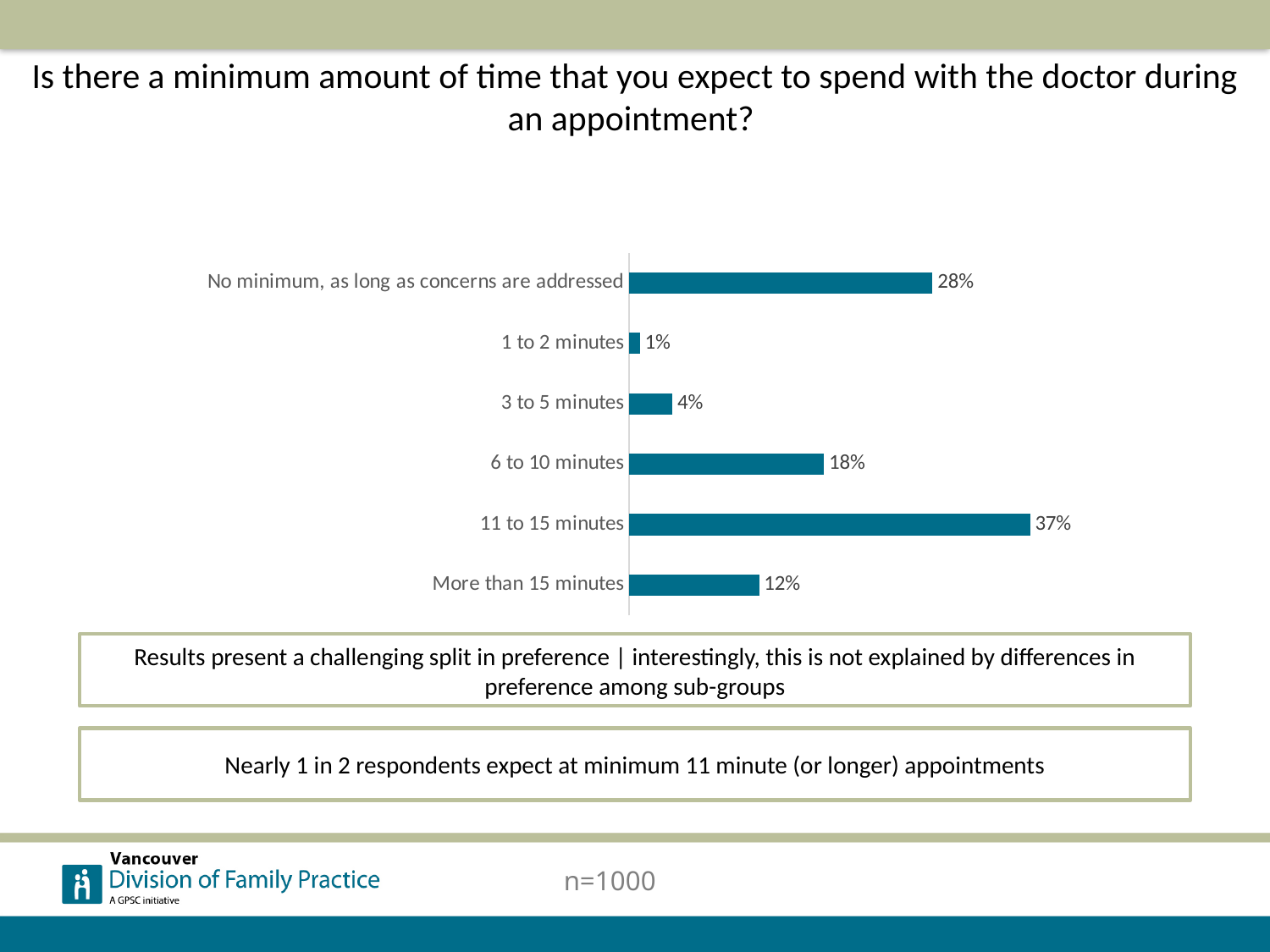
Which category has the lowest percentage? 1 to 2 minutes What is the difference in percentage points between "11 to 15 minutes" and "6 to 10 minutes"? 19 What is the combined percentage for "11 to 15 minutes" and "More than 15 minutes"? 49% What percentage of respondents chose "No minimum, as long as concerns are addressed"? 28% What kind of chart is shown on the slide? Bar chart What percentage of respondents chose "11 to 15 minutes"? 37% Which is larger: the value for "6 to 10 minutes" or the value for "More than 15 minutes"? 6 to 10 minutes What percentage of respondents chose "More than 15 minutes"? 12% What sample size (n) is shown on the slide? n=1000 What percentage of respondents chose "3 to 5 minutes"? 4% Which category has the highest percentage? 11 to 15 minutes How many categories are shown in the chart? 6